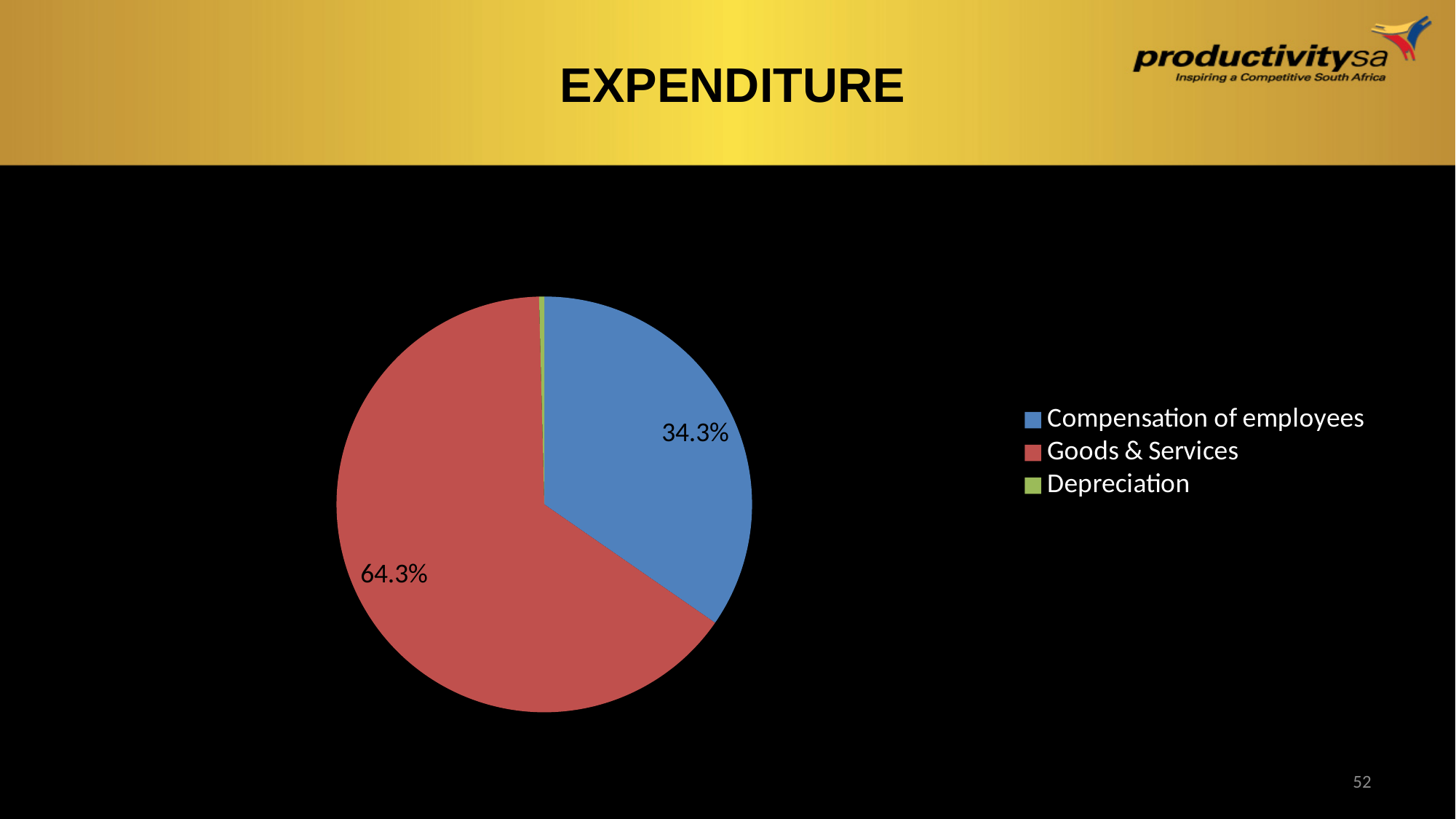
Which colour represents Depreciation in the pie chart? Green What is the difference in percentage points between the Goods & Services share and the Compensation of employees share? 30 percentage points What is the title of the slide containing the chart? EXPENDITURE Which category has the smallest share of expenditure? Depreciation Is the share for Goods & Services greater or less than 50%? greater What share of expenditure is Compensation of employees? 34.3% What share of expenditure is Goods & Services? 64.3% How many categories does the pie chart show? 3 Which category has the largest share of expenditure? Goods & Services What kind of chart is shown on the slide? Pie chart Which is larger, the share for Goods & Services or the share for Compensation of employees? Goods & Services